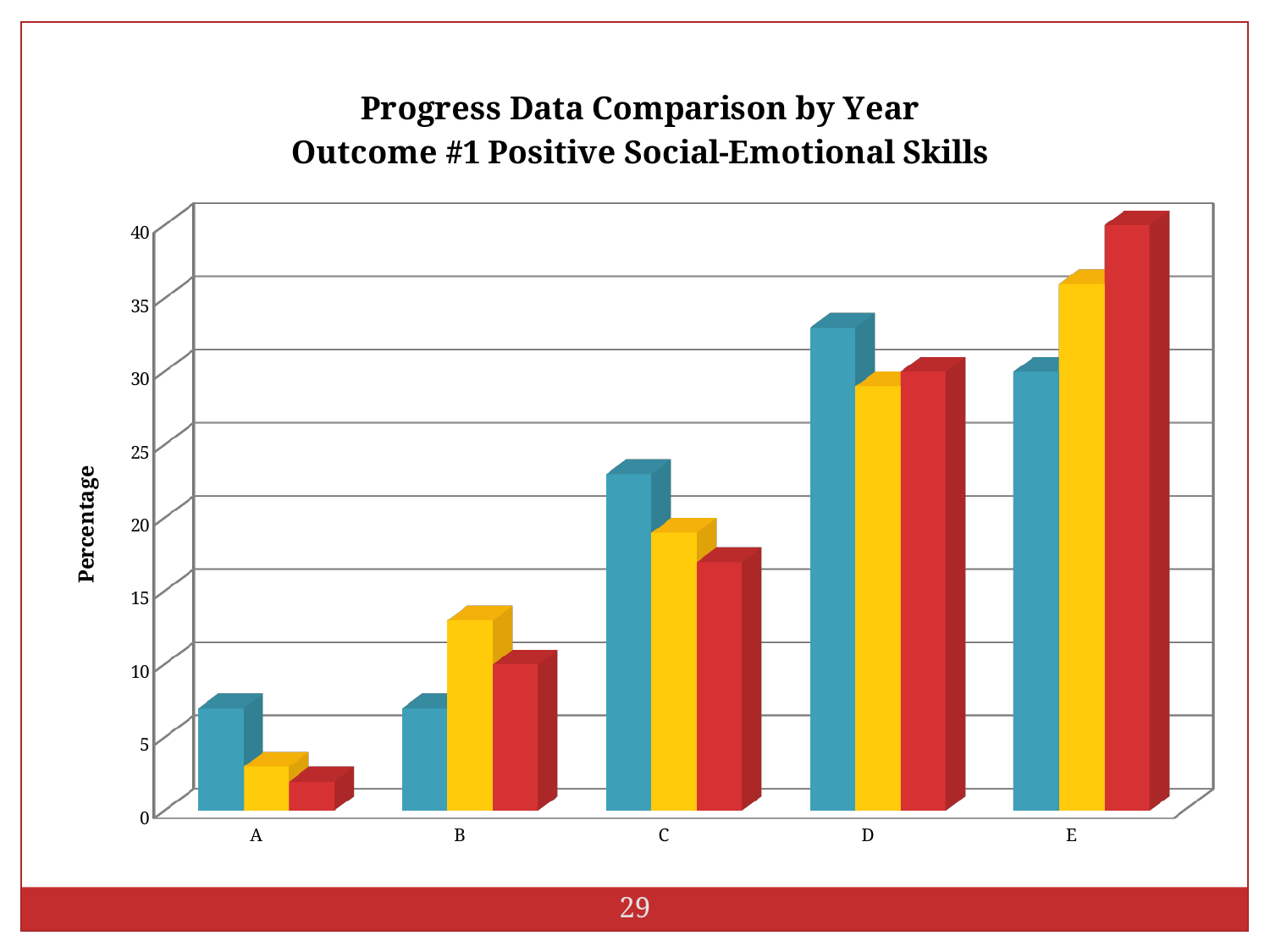
What is the label of the vertical axis? Percentage Which category has the shortest yellow bar? A Which category has the tallest blue bar? D Do the red bars rise or fall from category A to category E? Rise Which is larger, the blue bar for D or the blue bar for E? The blue bar for D Which category has the tallest red bar? E What is the first line of the chart title? Progress Data Comparison by Year Is the yellow bar for A greater or less than 5? less What kind of chart is shown on the slide? Bar chart Is the red bar for E greater or less than 35? greater Is the blue bar for D greater or less than 30? greater How many categories are shown on the x axis? 5